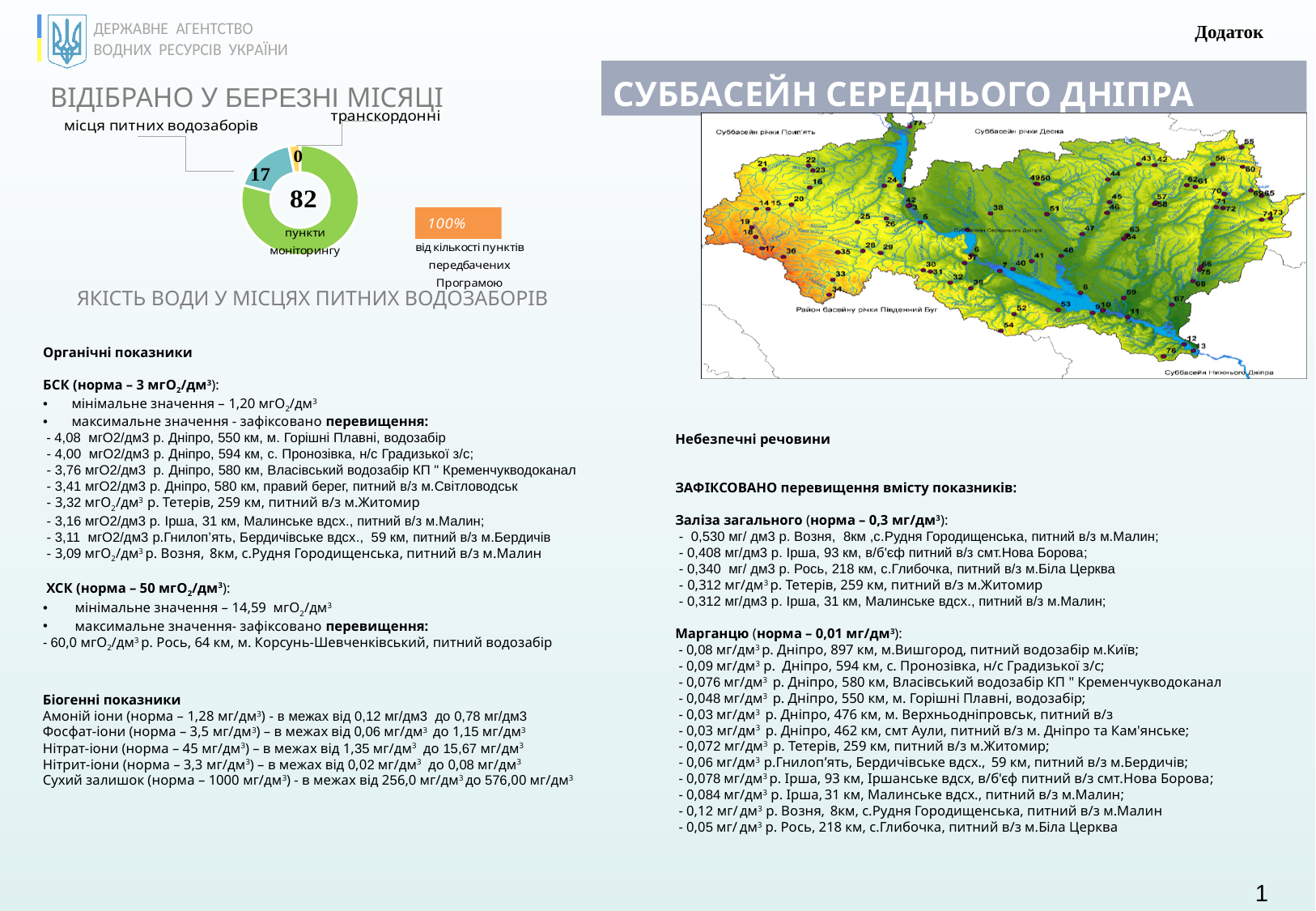
What number is printed in the centre of the doughnut chart for "пункти моніторингу"? 82 What is the difference between the value for "пункти моніторингу" (82) and "місця питних водозаборів" (17) in the doughnut chart? 65 In the doughnut chart, what value is shown for "транскордонні"? 0 Which category in the doughnut chart has the highest value? пункти моніторингу What kind of chart is shown under the heading "ВІДІБРАНО У БЕРЕЗНІ МІСЯЦІ"? doughnut chart In the doughnut chart, what value is shown for "місця питних водозаборів"? 17 How many labelled segments does the doughnut chart have? 3 Which category in the doughnut chart has the lowest value? транскордонні What percentage is shown in the orange box next to the doughnut chart? 100% What colour is the largest segment of the doughnut chart? green In the doughnut chart, which is larger: the value for "місця питних водозаборів" or for "транскордонні"? місця питних водозаборів